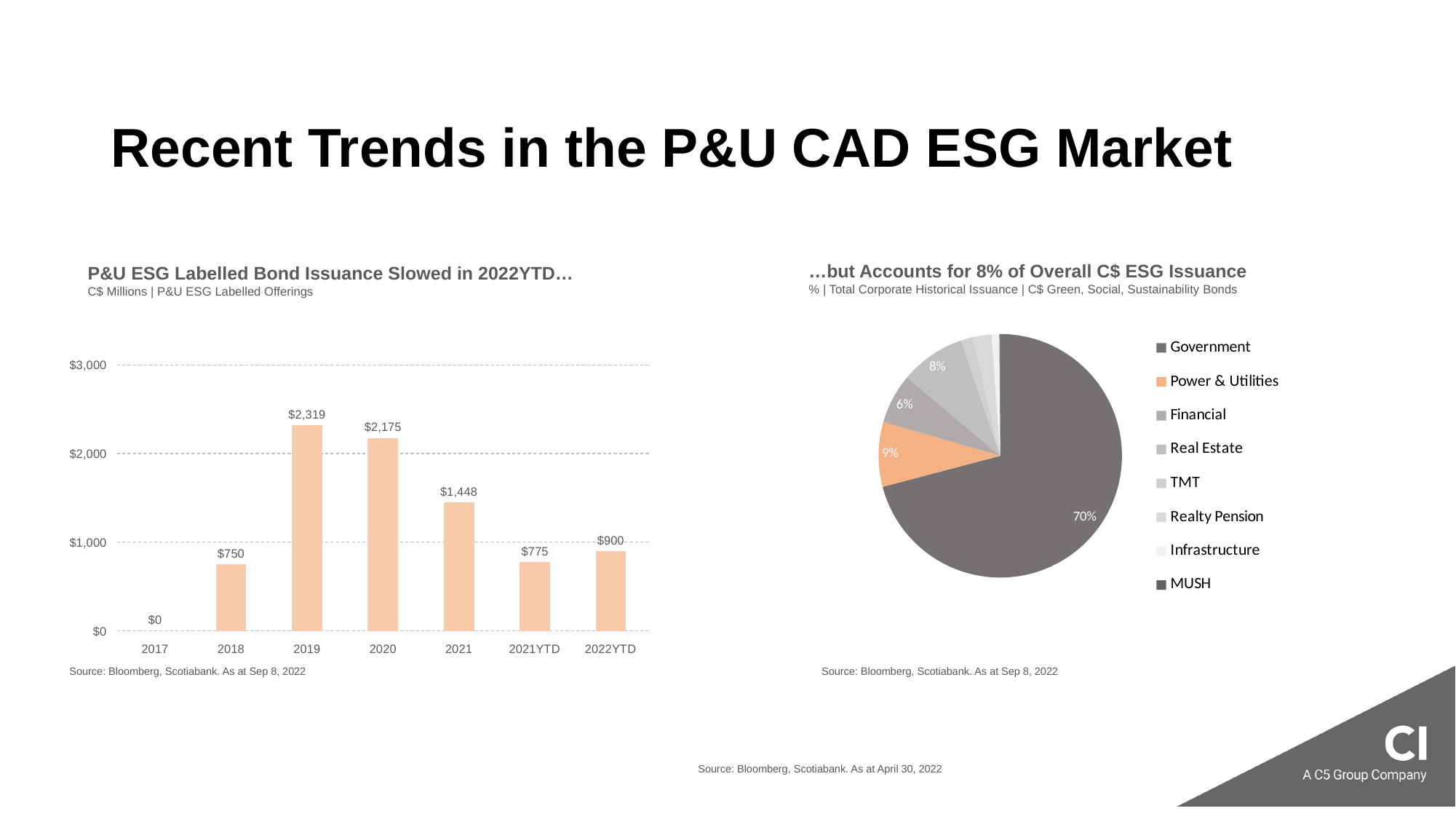
What type of chart is the left chart? Bar chart On the left chart, which year has the highest issuance? 2019 On the right pie chart, what share is labelled on the Government slice? 70% On the left chart, which year has the lowest issuance? 2017 On the right pie chart, what share is labelled on the orange Power & Utilities slice? 9% On the left chart, did issuance rise or fall from 2019 to 2021? Fall On the left chart, what is the value shown for 2022YTD? $900 How many entries does the legend of the right pie chart list? 8 On the left chart, what was the P&U ESG labelled bond issuance in 2019? $2,319 On the left chart, which is larger, the value for 2021YTD or 2022YTD? 2022YTD On the left chart, what is the difference between the 2019 and 2020 values? $144 On the left chart, how many years or periods are shown on the x axis? 7